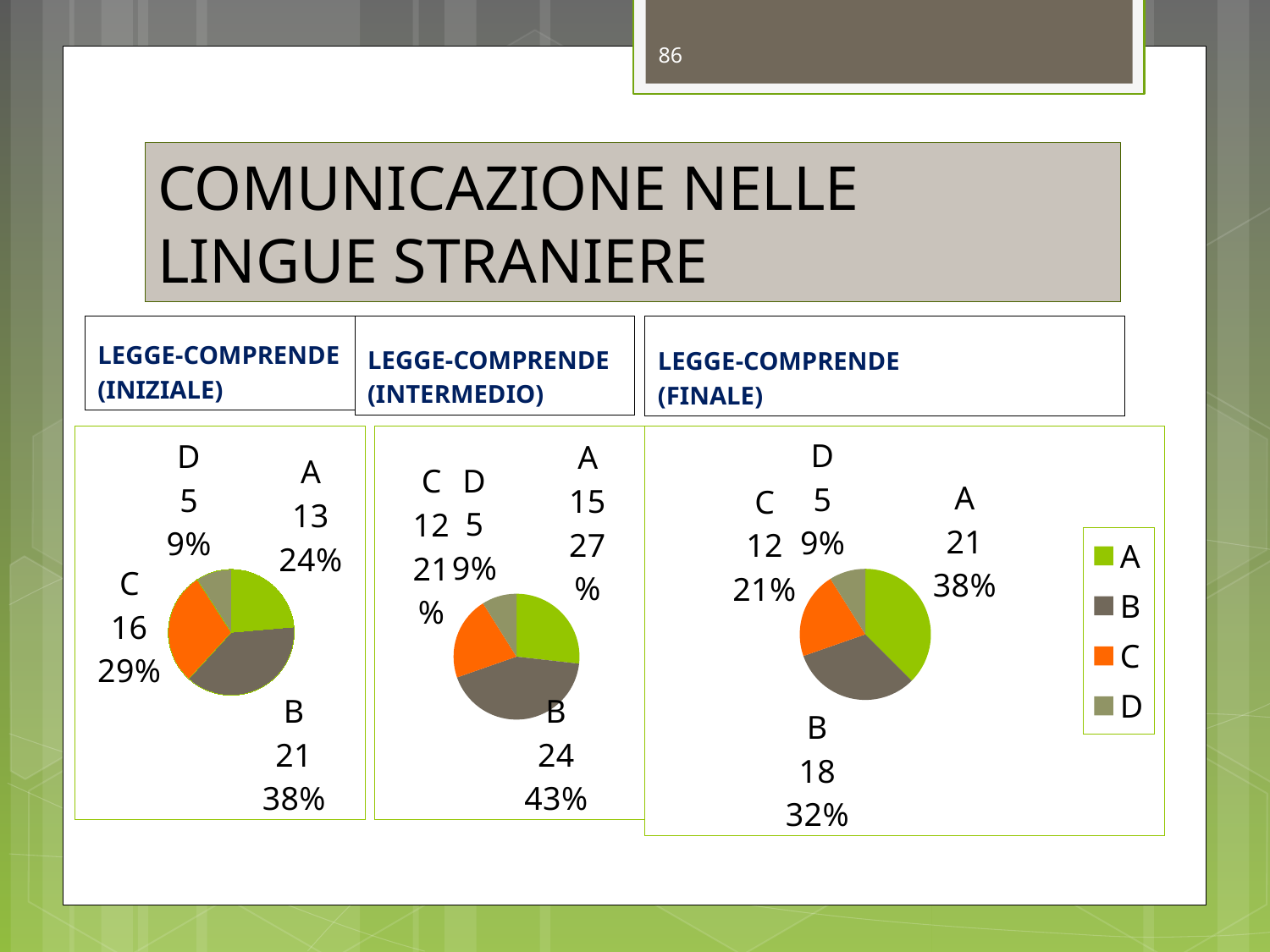
How many categories does the LEGGE-COMPRENDE (INIZIALE) pie chart show? 4 In the LEGGE-COMPRENDE (INTERMEDIO) pie chart, what percentage share does category B have? 43% In the LEGGE-COMPRENDE (INIZIALE) pie chart, what value is shown for category B? 21 How many entries does the legend next to the LEGGE-COMPRENDE (FINALE) chart list? 4 In the LEGGE-COMPRENDE (INTERMEDIO) pie chart, which category has the largest slice? B In the LEGGE-COMPRENDE (FINALE) pie chart, what value is shown for category A? 21 What type of chart is used for LEGGE-COMPRENDE (FINALE)? Pie chart In the LEGGE-COMPRENDE (FINALE) pie chart, what is the difference between the values for A and B? 3 In the LEGGE-COMPRENDE (FINALE) pie chart, which category has the smallest slice? D In the LEGGE-COMPRENDE (FINALE) pie chart, which is larger, the value for A or the value for C? A In the LEGGE-COMPRENDE (INTERMEDIO) pie chart, what value is shown for category A? 15 In the LEGGE-COMPRENDE (INIZIALE) pie chart, what percentage share does category C have? 29%